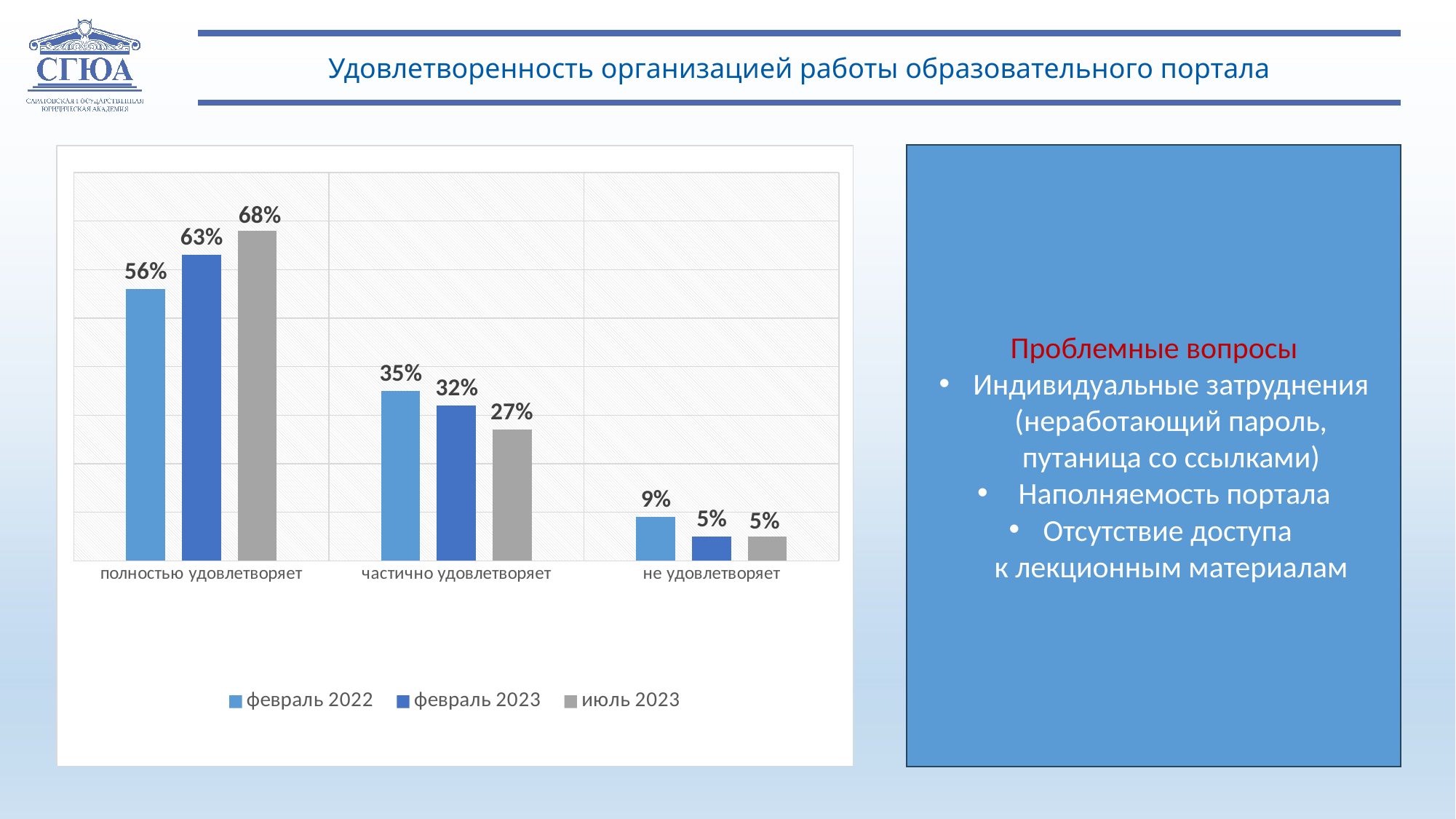
Which category has the highest value in the 'июль 2023' series? полностью удовлетворяет Do the values for 'полностью удовлетворяет' rise or fall from 'февраль 2022' to 'июль 2023'? rise What is the value for 'частично удовлетворяет' in the 'июль 2023' series? 27% Which is larger for 'частично удовлетворяет': the 'февраль 2022' value or the 'февраль 2023' value? февраль 2022 Which category has the lowest value in the 'февраль 2022' series? не удовлетворяет What is the value for 'полностью удовлетворяет' in the 'февраль 2022' series? 56% What is the value for 'не удовлетворяет' in the 'февраль 2023' series? 5% What is the difference between the 'июль 2023' and 'февраль 2022' values for 'полностью удовлетворяет'? 12% Which series is shown in grey in the legend? июль 2023 How many series does the legend list? 3 How many categories are shown on the x axis? 3 What kind of chart is shown on the slide? bar chart